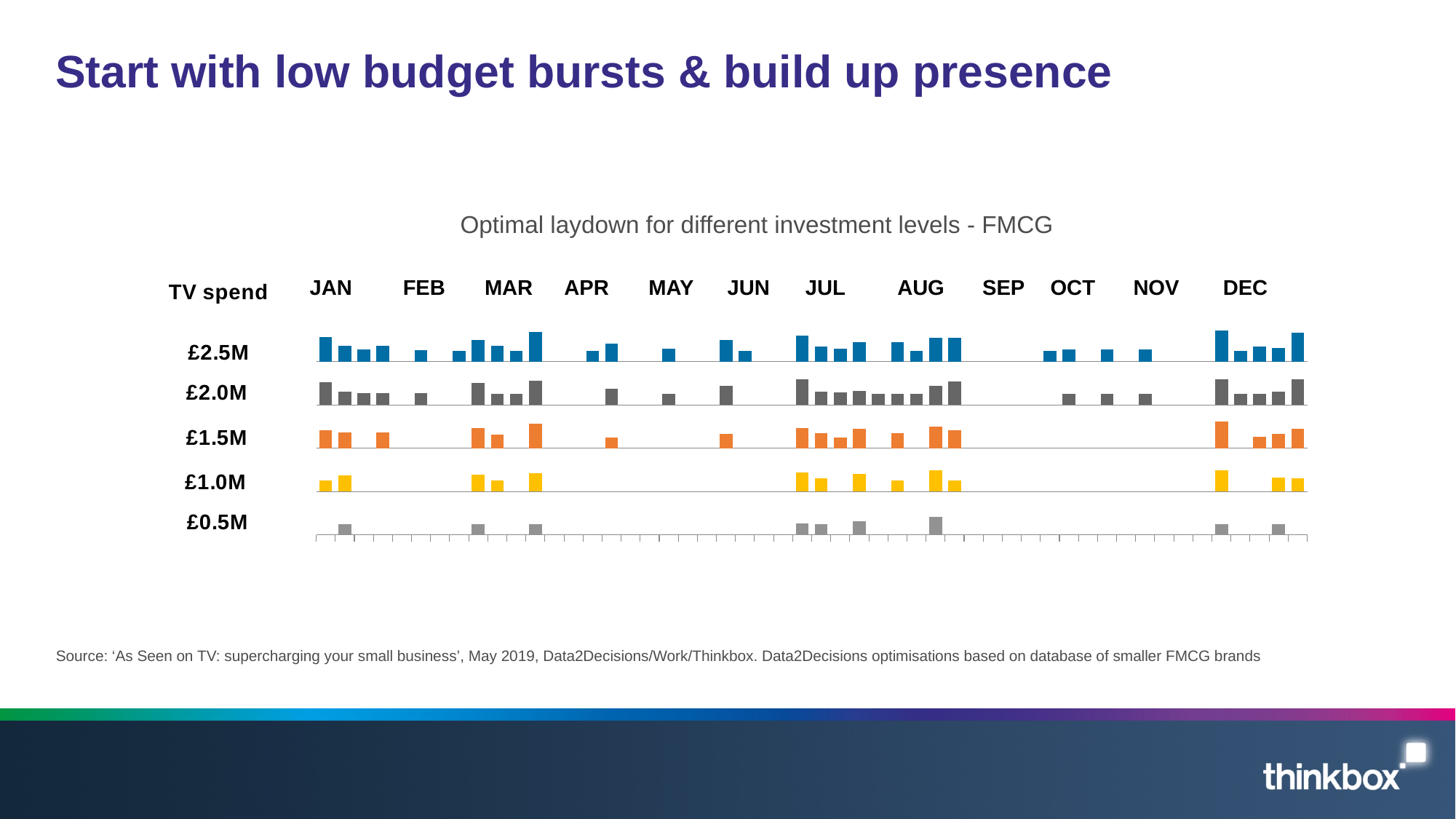
As the TV spend level increases from £0.5M to £2.5M, does the number of weeks with activity rise or fall? Rise Which TV spend level has bars in the most weeks? £2.5M Does the £2.5M spend level have any bars in OCT? Yes How many TV spend levels are shown as rows in the chart? 5 Does the £0.5M spend level have any bars in MAY? No Which TV spend level has bars in the fewest weeks? £0.5M Which has bars in more months, the £1.0M level or the £2.0M level? £2.0M How many months are labelled along the top of the chart? 12 Which month has no bars at any TV spend level? SEP What is the title of the chart? Optimal laydown for different investment levels - FMCG What kind of chart is shown on the slide? Bar chart Which TV spend level is plotted in orange? £1.5M